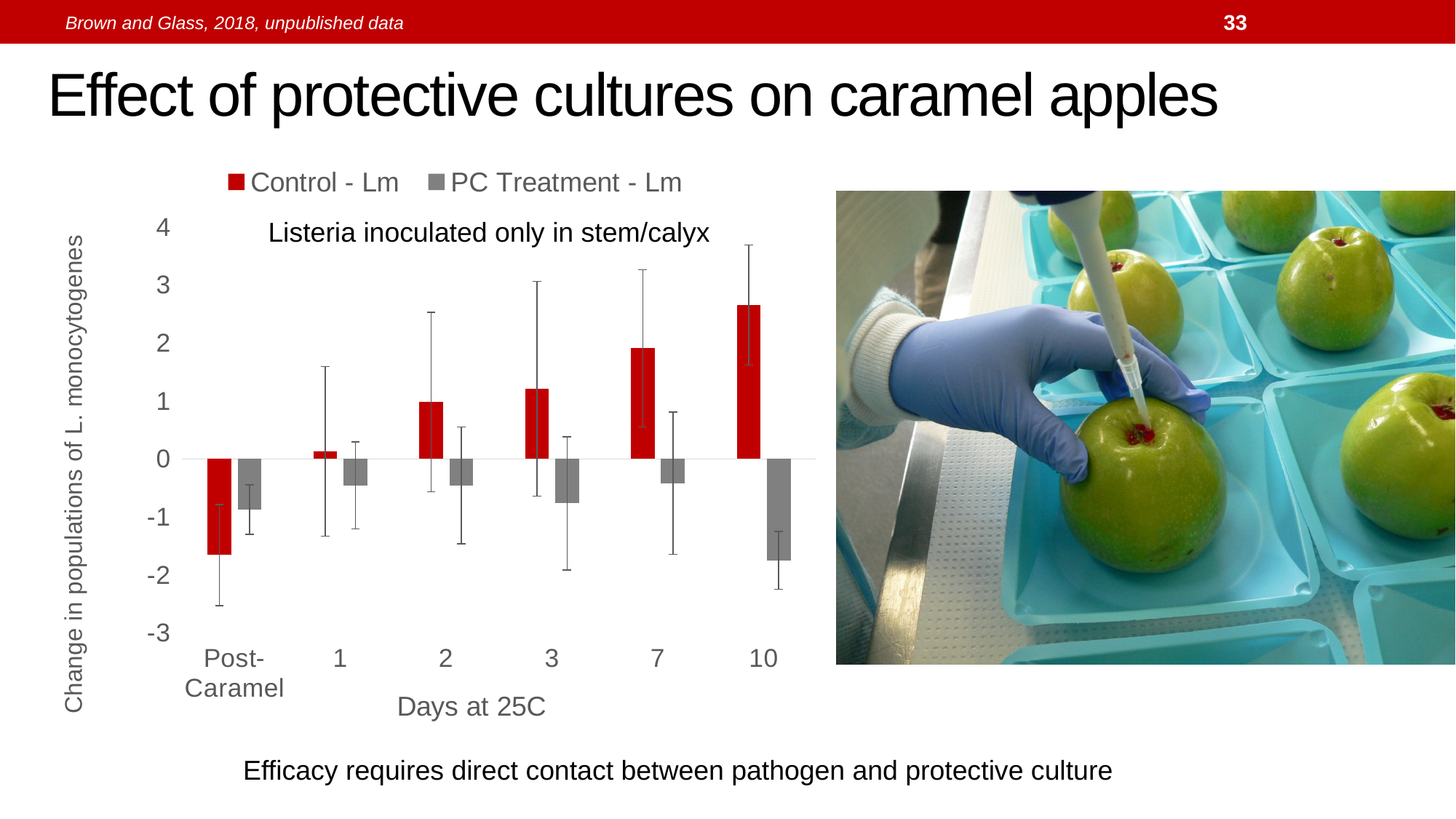
At which x-axis category is the Control - Lm value lowest? Post-Caramel What is the title of the x axis? Days at 25C Which is larger, the Control - Lm value at day 7 or at day 2? day 7 Is the Control - Lm value at day 10 greater or less than 2? greater What kind of chart is shown on the slide? bar chart Do the Control - Lm values rise or fall from day 1 to day 10? rise At which x-axis category is the Control - Lm value highest? 10 How many categories are shown along the x axis? 6 Is the PC Treatment - Lm value at day 10 greater or less than -1? less How many series does the legend list? 2 At which x-axis category is the PC Treatment - Lm value lowest? 10 Is the Control - Lm value at Post-Caramel greater or less than -1? less